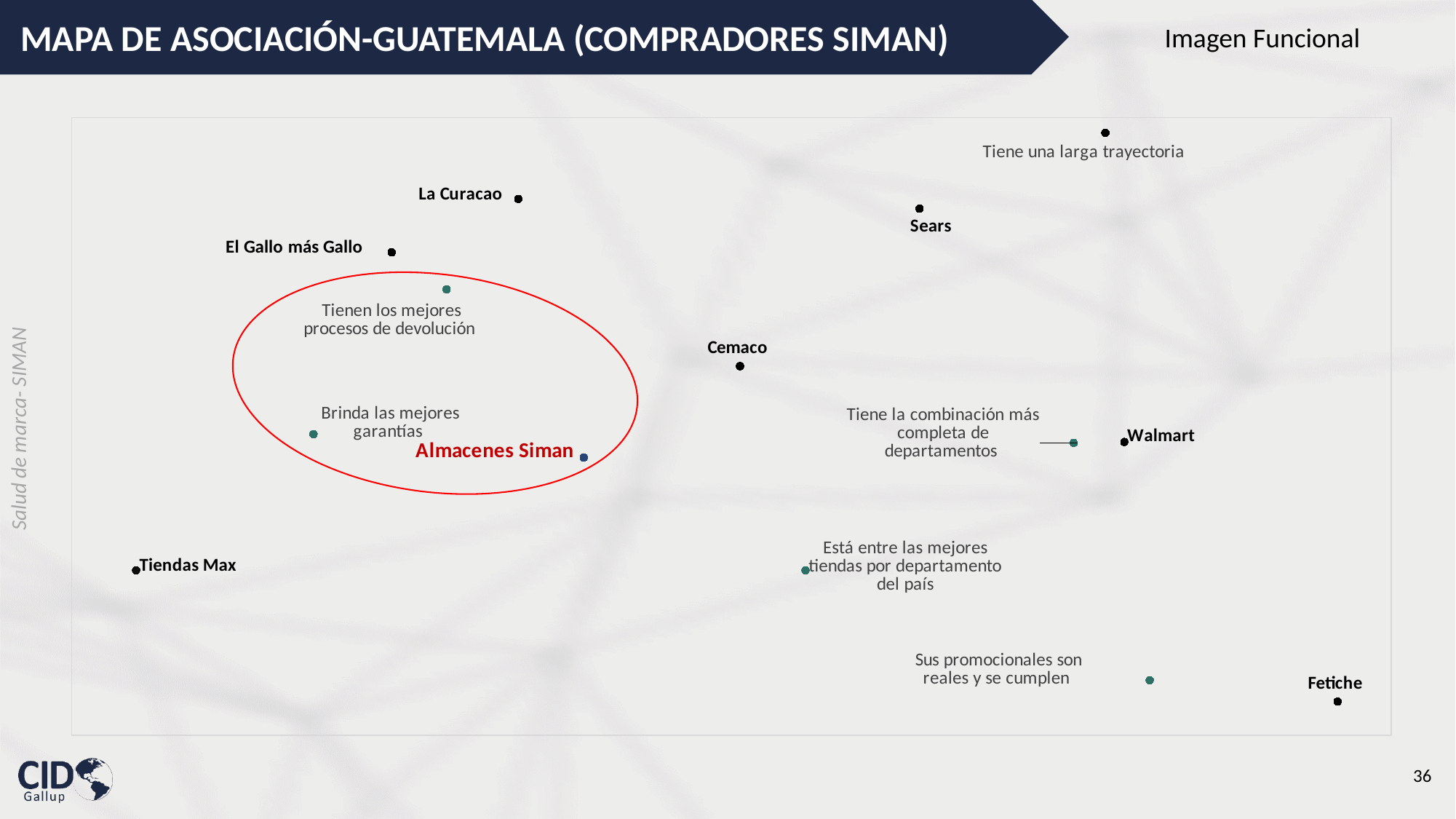
Which point is positioned highest on the map? Tiene una larga trayectoria Which attribute is connected by a line to Walmart on the map? Tiene la combinación más completa de departamentos How many attribute statements are plotted on the association map? 6 Which brand is enclosed by the red ellipse on the map? Almacenes Siman Which two attributes are inside the red ellipse with Almacenes Siman? Tienen los mejores procesos de devolución; Brinda las mejores garantías Which brand is plotted in the bottom-left corner of the map? Tiendas Max Which brand is plotted closest to the attribute 'Sus promocionales son reales y se cumplen'? Fetiche What is the title of the chart on the slide? MAPA DE ASOCIACIÓN-GUATEMALA (COMPRADORES SIMAN) Which brand label is written in red on the map? Almacenes Siman Which brand is plotted closest to the attribute 'Tiene una larga trayectoria'? Sears How many brand names are plotted on the association map? 8 What kind of chart is shown on the slide? Scatter plot (association map)